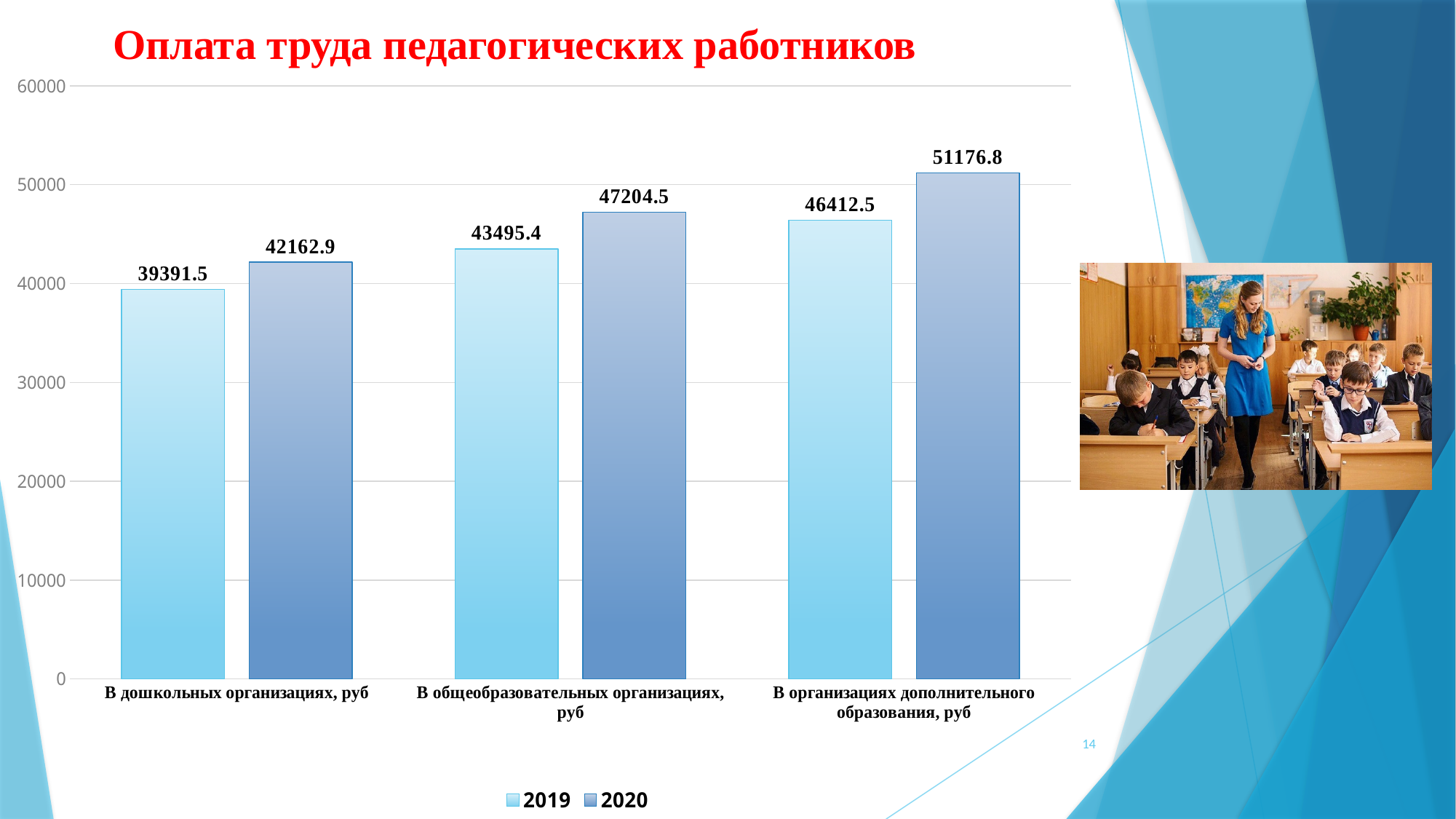
How many series does the legend list? 2 Which category has the highest 2020 value? В организациях дополнительного образования, руб How many categories are shown on the x axis? 3 Is the 2020 value for «В организациях дополнительного образования, руб» greater or less than 50000? greater What is the 2019 value for «В дошкольных организациях, руб»? 39391.5 What is the 2020 value for «В общеобразовательных организациях, руб»? 47204.5 Which is larger: the 2019 value for «В организациях дополнительного образования, руб» or the 2020 value for «В общеобразовательных организациях, руб»? 2020 value for «В общеобразовательных организациях, руб» What is the difference between the 2020 and 2019 values for «В дошкольных организациях, руб»? 2771.4 What type of chart is shown on the slide? bar chart What is the difference between the 2020 and 2019 values for «В организациях дополнительного образования, руб»? 4764.3 What is the 2020 value for «В организациях дополнительного образования, руб»? 51176.8 Which category has the lowest 2019 value? В дошкольных организациях, руб